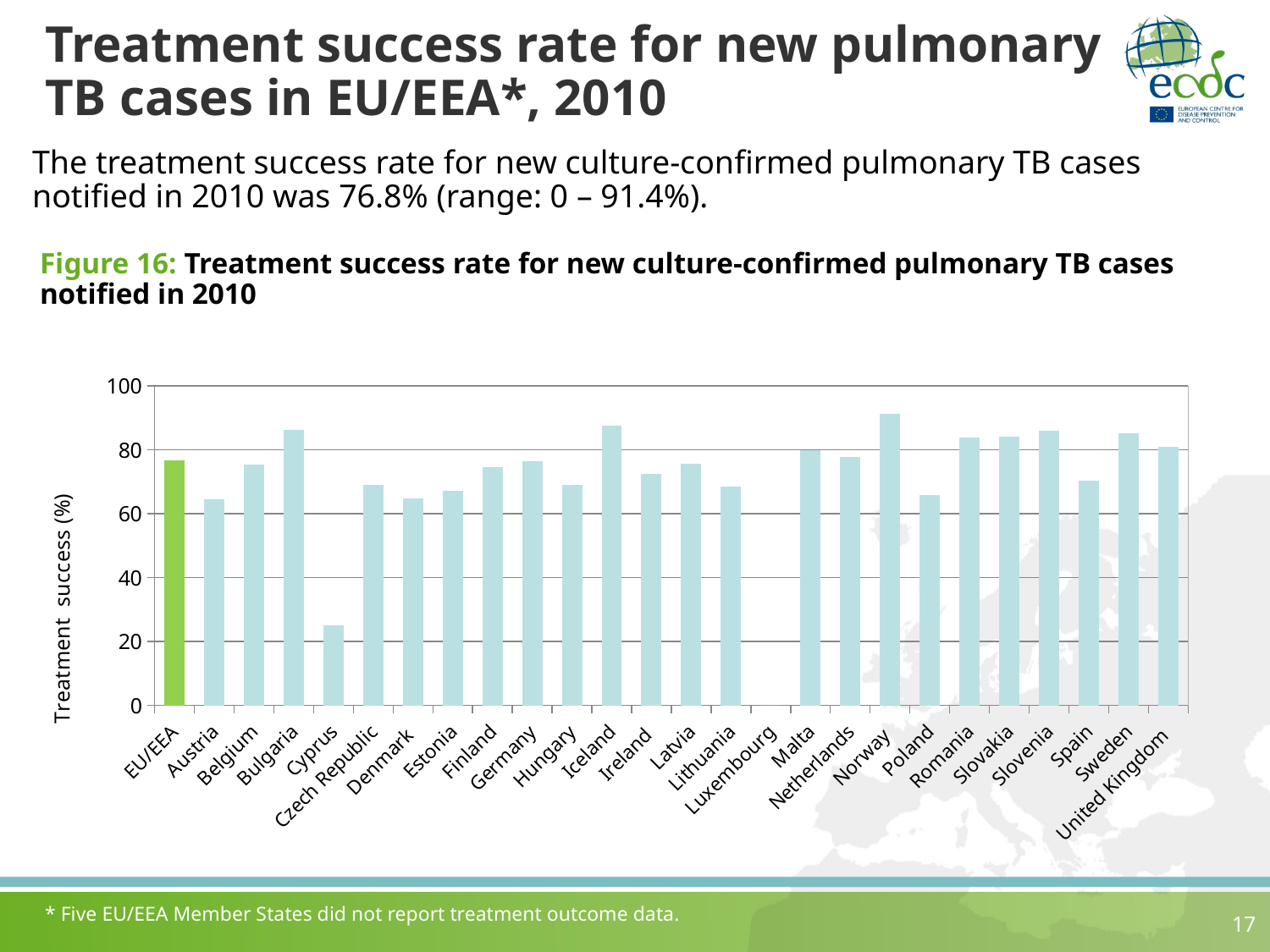
What is the treatment success rate for EU/EEA as stated on the slide? 76.8% Which country has the lowest treatment success rate in the chart? Luxembourg What kind of chart is shown in Figure 16? Bar chart Is the treatment success rate for Cyprus greater or less than 40? less Is the treatment success rate for Spain greater or less than 80? less Which country has the highest treatment success rate in the chart? Norway How many categories (bars) are shown along the x axis of the chart? 26 Which has a higher treatment success rate, Norway or Poland? Norway Which bar in the chart is coloured green rather than light blue? EU/EEA Is the treatment success rate for Poland greater or less than 60? greater Which has a higher treatment success rate, Iceland or Ireland? Iceland